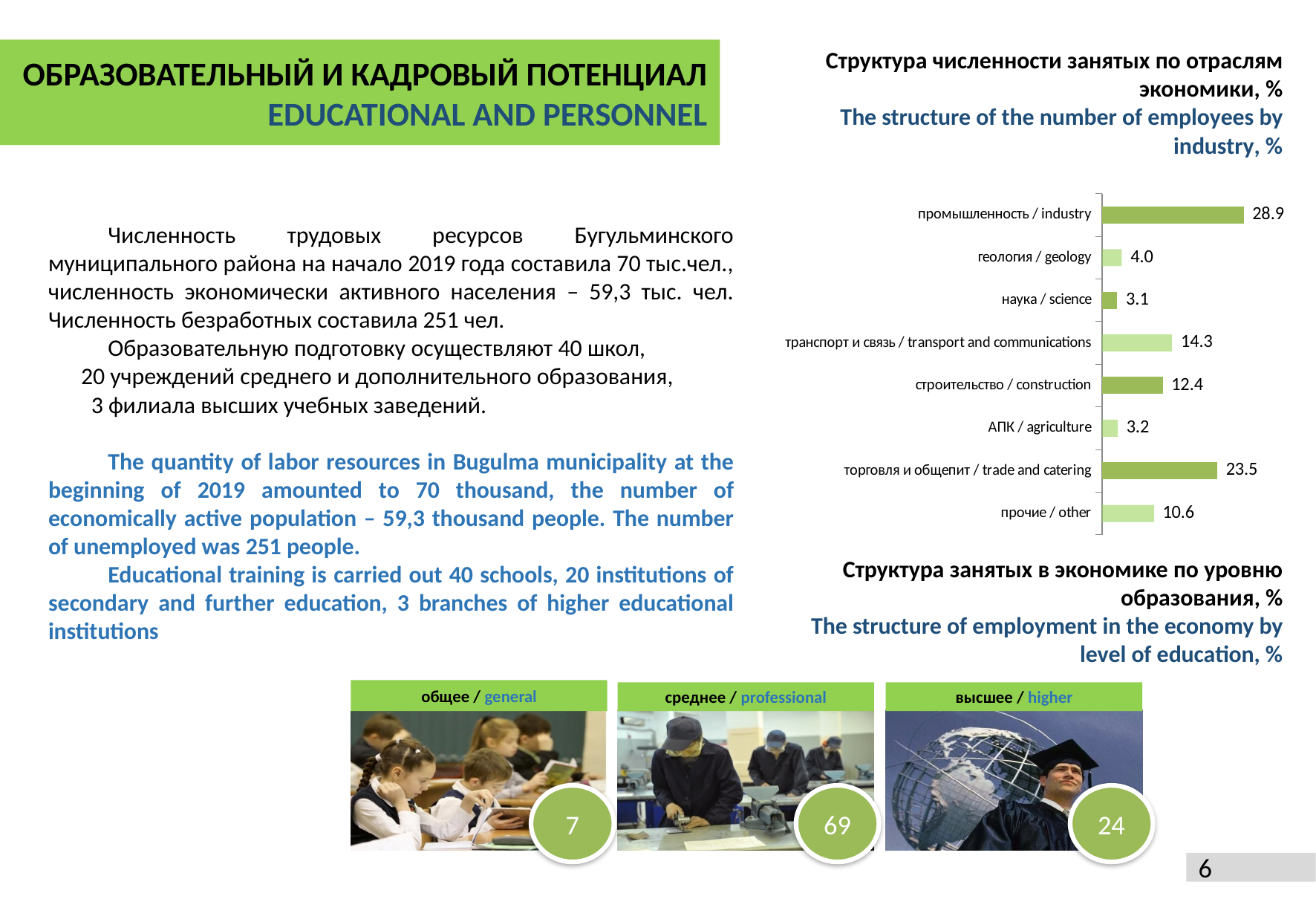
What is the value for торговля и общепит / trade and catering in the bar chart? 23.5 Which is larger in the bar chart: геология / geology or АПК / agriculture? геология / geology Which category has the highest value in the chart 'The structure of the number of employees by industry, %'? промышленность / industry What is the Russian title of the bar chart on the slide? Структура численности занятых по отраслям экономики, % What kind of chart is 'The structure of the number of employees by industry, %'? bar chart What is the difference between the values for транспорт и связь / transport and communications and строительство / construction? 1.9 What is the value for прочие / other in the bar chart? 10.6 What is the difference between the values for промышленность / industry and торговля и общепит / trade and catering? 5.4 How many categories are shown in the chart 'The structure of the number of employees by industry, %'? 8 Which category has the lowest value in the bar chart? наука / science What is the value for промышленность / industry in the chart 'The structure of the number of employees by industry, %'? 28.9 What is the value for транспорт и связь / transport and communications in the bar chart? 14.3